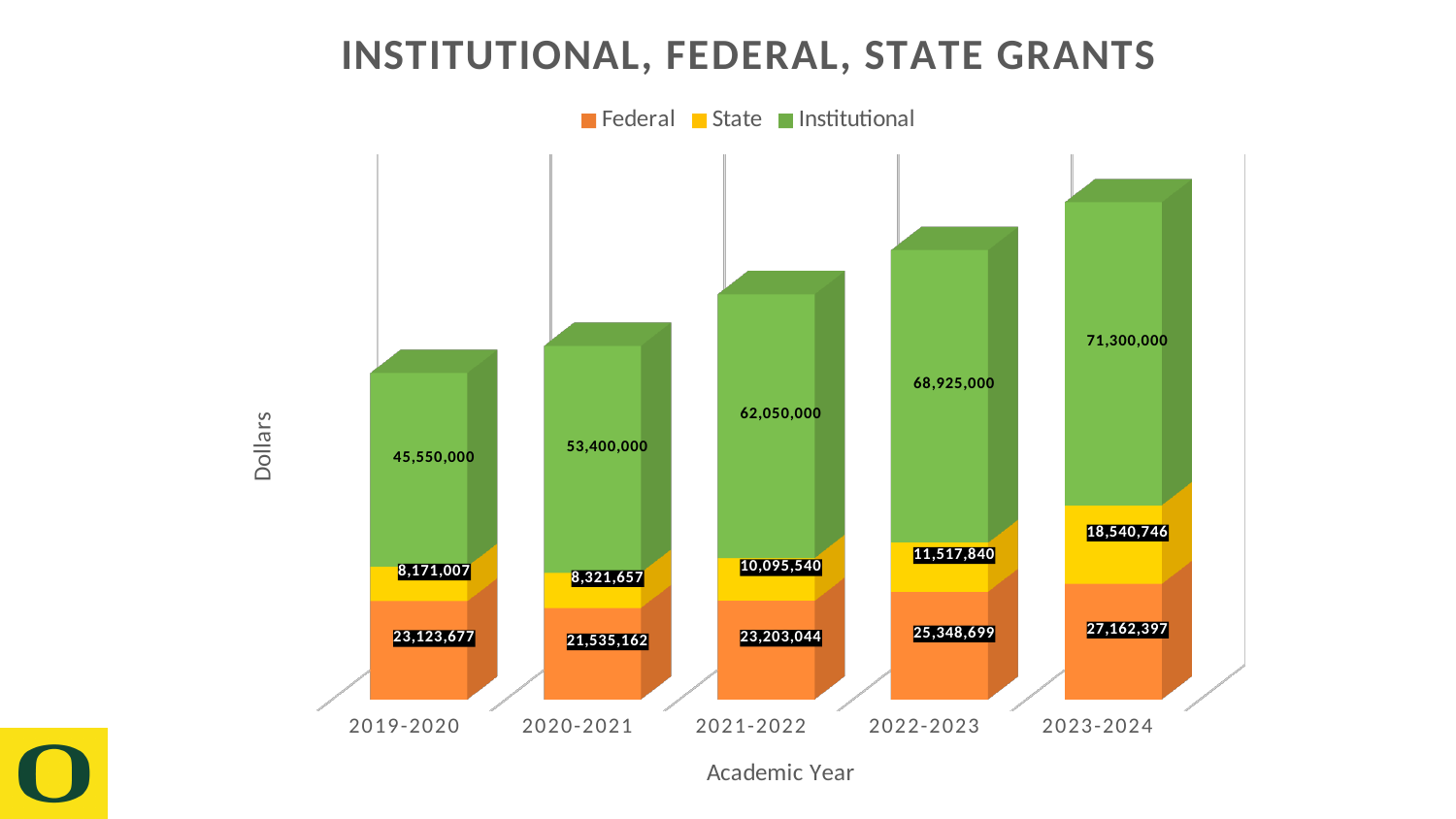
Which is larger, the State grant value for 2022-2023 or for 2021-2022? 2022-2023 How many series does the legend list? 3 What is the State grant value for 2023-2024? 18,540,746 What kind of chart is shown on the slide? Stacked bar chart Which academic year has the lowest Federal grant value? 2020-2021 Which academic year has the highest Institutional grant value? 2023-2024 What is the Institutional grant value for 2021-2022? 62,050,000 What is the Federal grant value for 2020-2021? 21,535,162 What is the difference between the Institutional grant values for 2023-2024 and 2019-2020? 25,750,000 Do the Institutional grant values rise or fall from 2019-2020 to 2023-2024? Rise How many academic years are shown on the x axis? 5 What is the total of the stacked bar for 2019-2020? 76,844,684